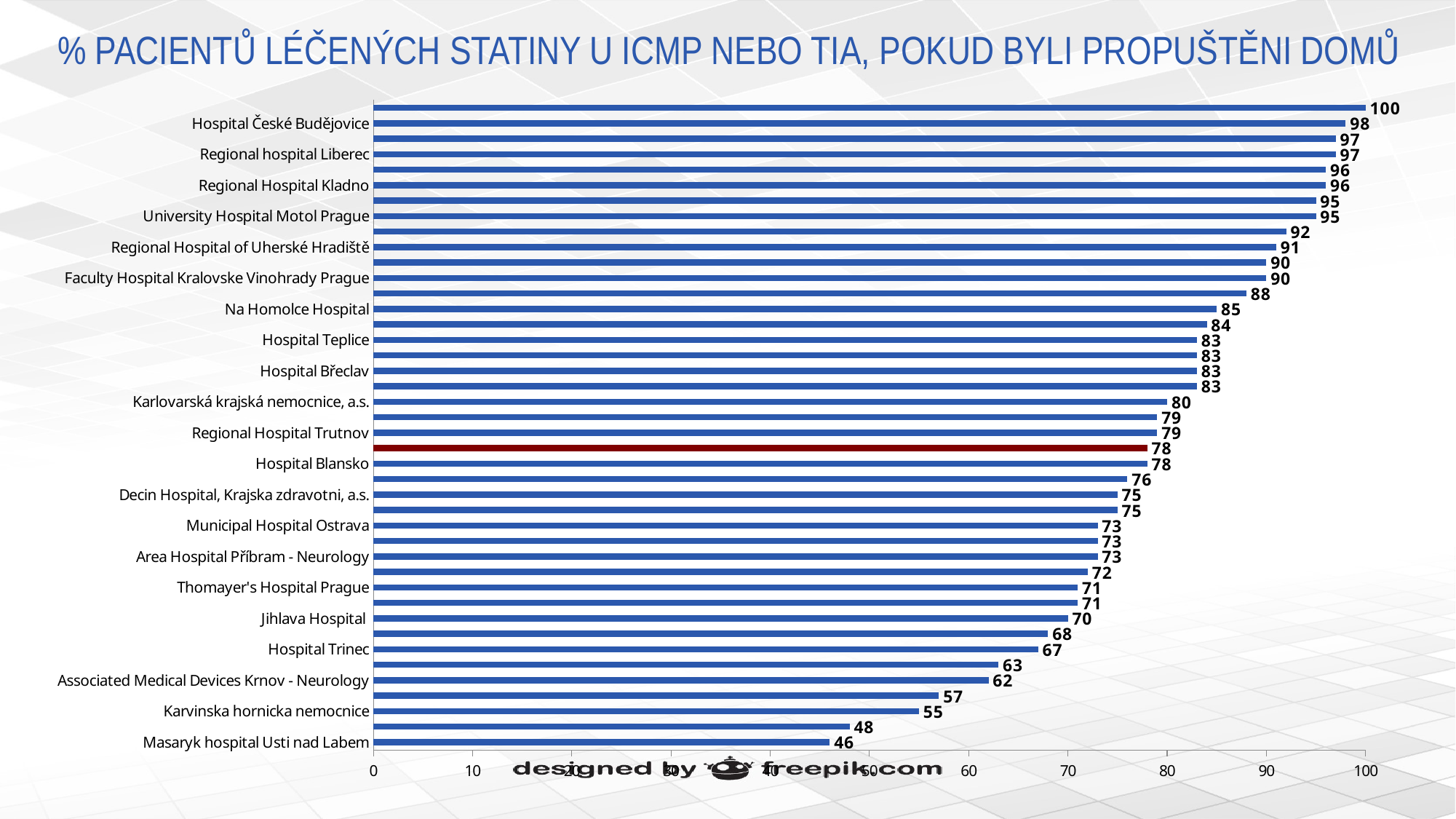
What value is shown on the bar highlighted in dark red? 78 What is the difference between the values for Regional hospital Liberec and Hospital Trinec? 30 Which labeled hospital has the lowest value? Masaryk hospital Usti nad Labem What kind of chart is shown on the slide? bar chart What is the value for Masaryk hospital Usti nad Labem? 46 What is the value for Hospital České Budějovice? 98 Is the value for Associated Medical Devices Krnov - Neurology greater or less than 70? less What is the value for Jihlava Hospital? 70 What is the value for Na Homolce Hospital? 85 What is the value for Karvinska hornicka nemocnice? 55 Which has a larger value, University Hospital Motol Prague or Hospital Teplice? University Hospital Motol Prague Do the values rise or fall going from the top bar to the bottom bar? fall